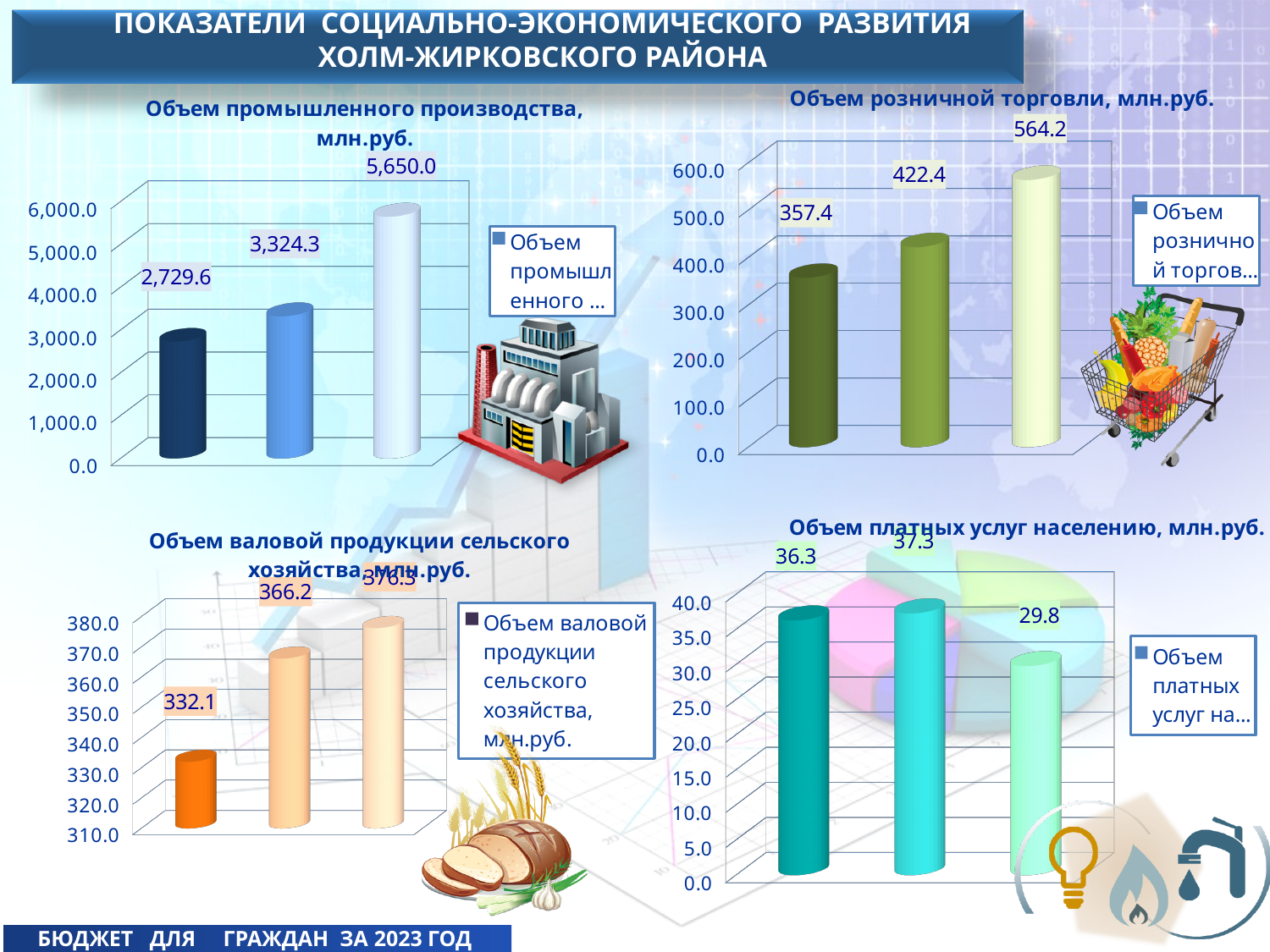
In the chart titled "Объем платных услуг населению, млн.руб.", which is larger: the first bar or the third bar? The first bar (36.3) In the chart titled "Объем розничной торговли, млн.руб.", do the values rise or fall from left to right? Rise In the chart titled "Объем розничной торговли, млн.руб.", what is the value of the second (middle) bar? 422.4 In the chart titled "Объем промышленного производства, млн.руб.", what is the value of the third (rightmost) bar? 5,650.0 In the chart titled "Объем розничной торговли, млн.руб.", which bar has the highest value? The third (rightmost) bar, 564.2 In the chart titled "Объем промышленного производства, млн.руб.", what is the value of the first (leftmost) bar? 2,729.6 How many bars are plotted in the chart titled "Объем платных услуг населению, млн.руб."? 3 In the chart titled "Объем валовой продукции сельского хозяйства, млн.руб.", what is the value of the first (leftmost) bar? 332.1 In the chart titled "Объем промышленного производства, млн.руб.", what is the difference between the third bar and the second bar? 2,325.7 In the chart titled "Объем валовой продукции сельского хозяйства, млн.руб.", which bar has the lowest value? The first (leftmost) bar, 332.1 What type of chart is used for "Объем промышленного производства, млн.руб."? Bar chart In the chart titled "Объем платных услуг населению, млн.руб.", what is the value of the third (rightmost) bar? 29.8